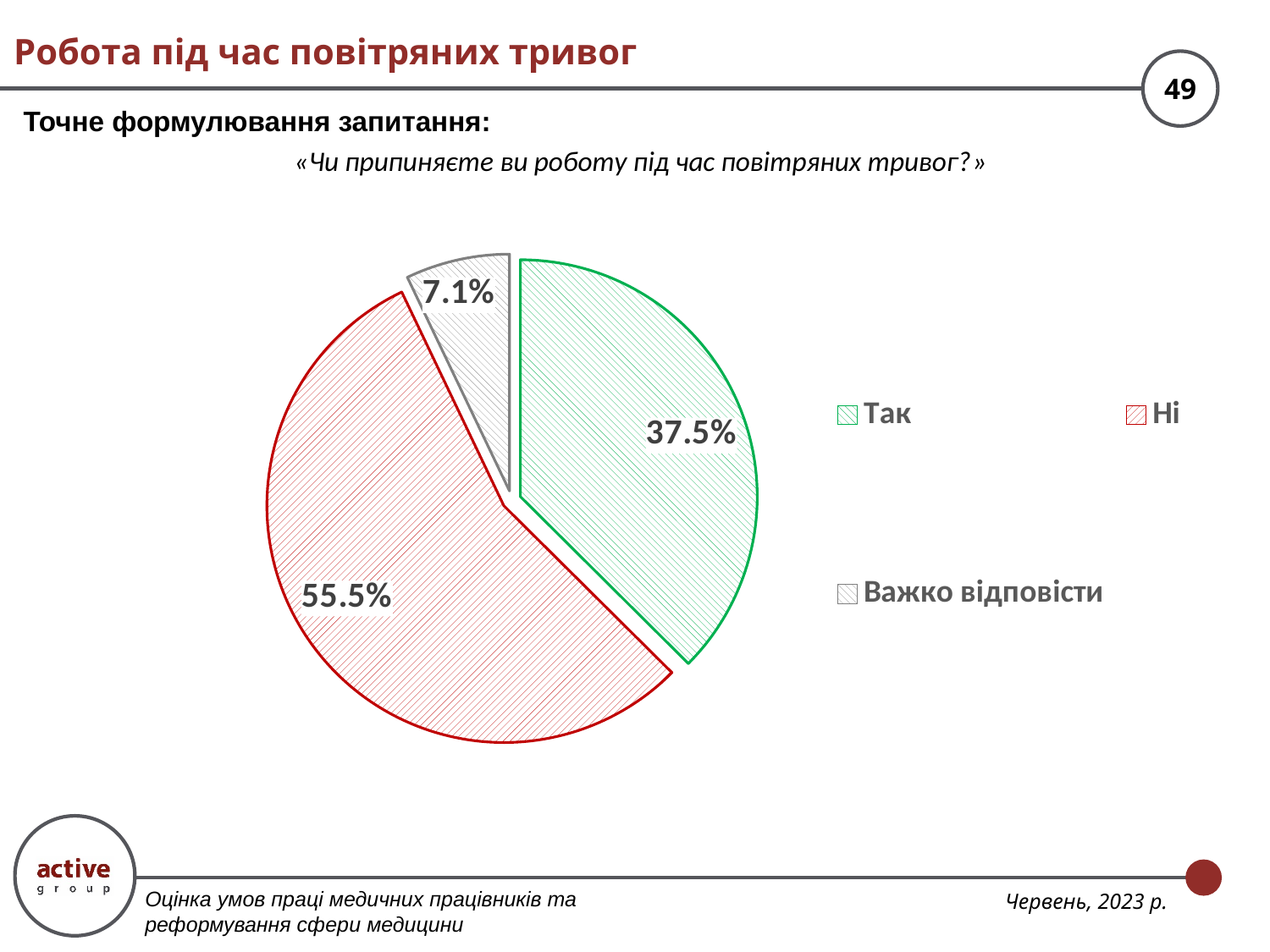
What is the difference between the shares for "Так" and "Важко відповісти"? 30.4% What type of chart is shown on the slide? pie chart Which is larger, the share for "Так" or the share for "Ні"? Ні What share of respondents answered "Ні"? 55.5% Which answer has the largest share of the pie? Ні What share of respondents answered "Так"? 37.5% What is the difference between the shares for "Ні" and "Так"? 18.0% What colour is the slice for "Ні"? red What share of respondents answered "Важко відповісти"? 7.1% How many entries does the legend list? 3 How many slices does the pie chart have? 3 Which answer has the smallest share of the pie? Важко відповісти